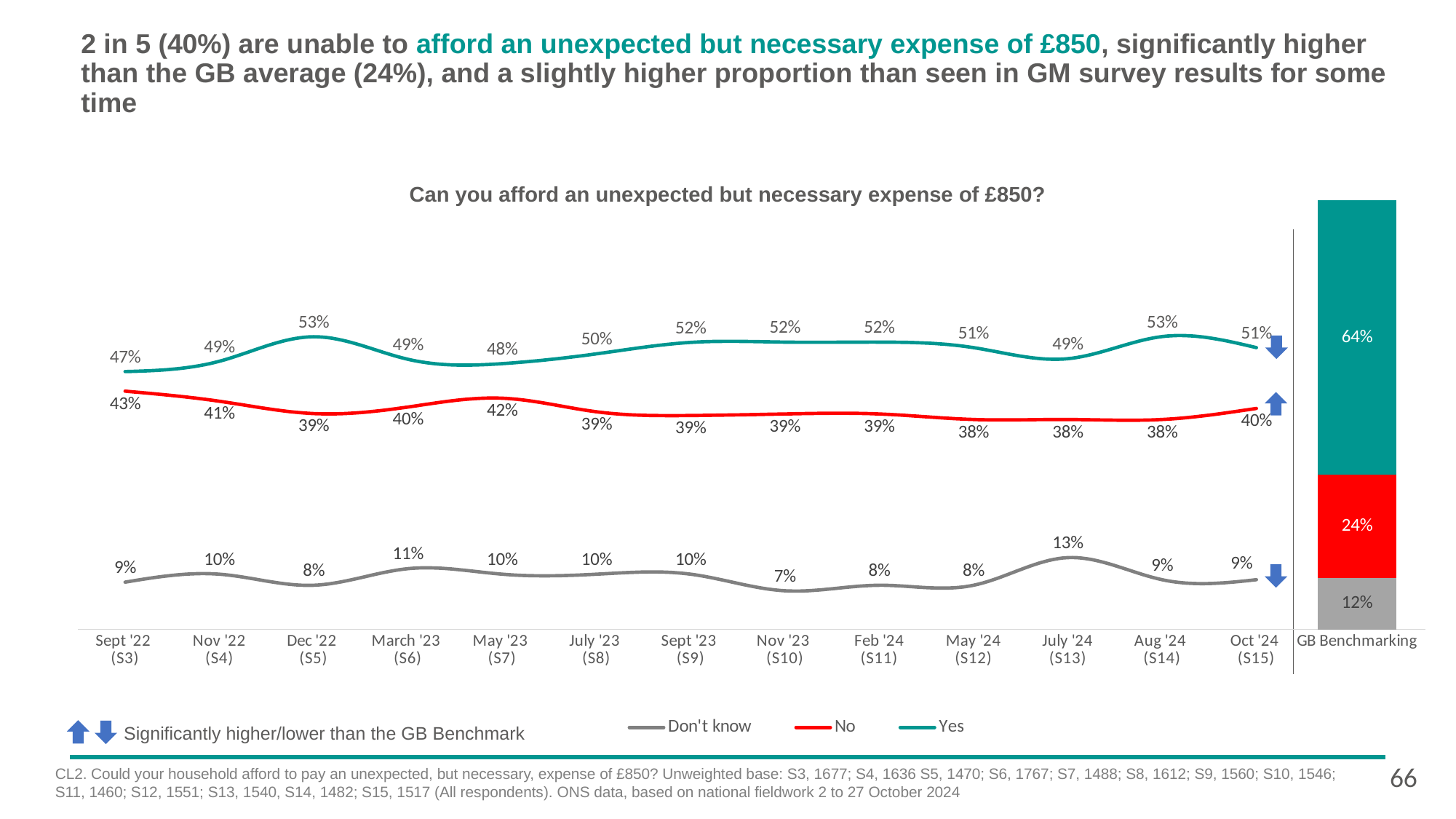
In which survey wave was the 'No' line at its highest? Sept '22 (S3) What is the 'No' share in the GB Benchmarking bar? 24% What is the 'Don't know' value for July '24 (S13)? 13% What do the three segments of the GB Benchmarking bar add up to? 100% How many survey waves are plotted on the line chart (excluding GB Benchmarking)? 13 What percentage answered 'No' in Oct '24 (S15)? 40% How many series does the legend list? 3 What is the difference in percentage points between 'Yes' and 'No' in Oct '24 (S15)? 11 percentage points What percentage answered 'Yes' in Sept '22 (S3)? 47% In which survey wave was the 'Don't know' line at its lowest? Nov '23 (S10) In which survey wave was the 'Yes' line at its lowest? Sept '22 (S3) Which is larger: the 'No' value for Oct '24 (S15) or the 'No' value in the GB Benchmarking bar? Oct '24 (S15)